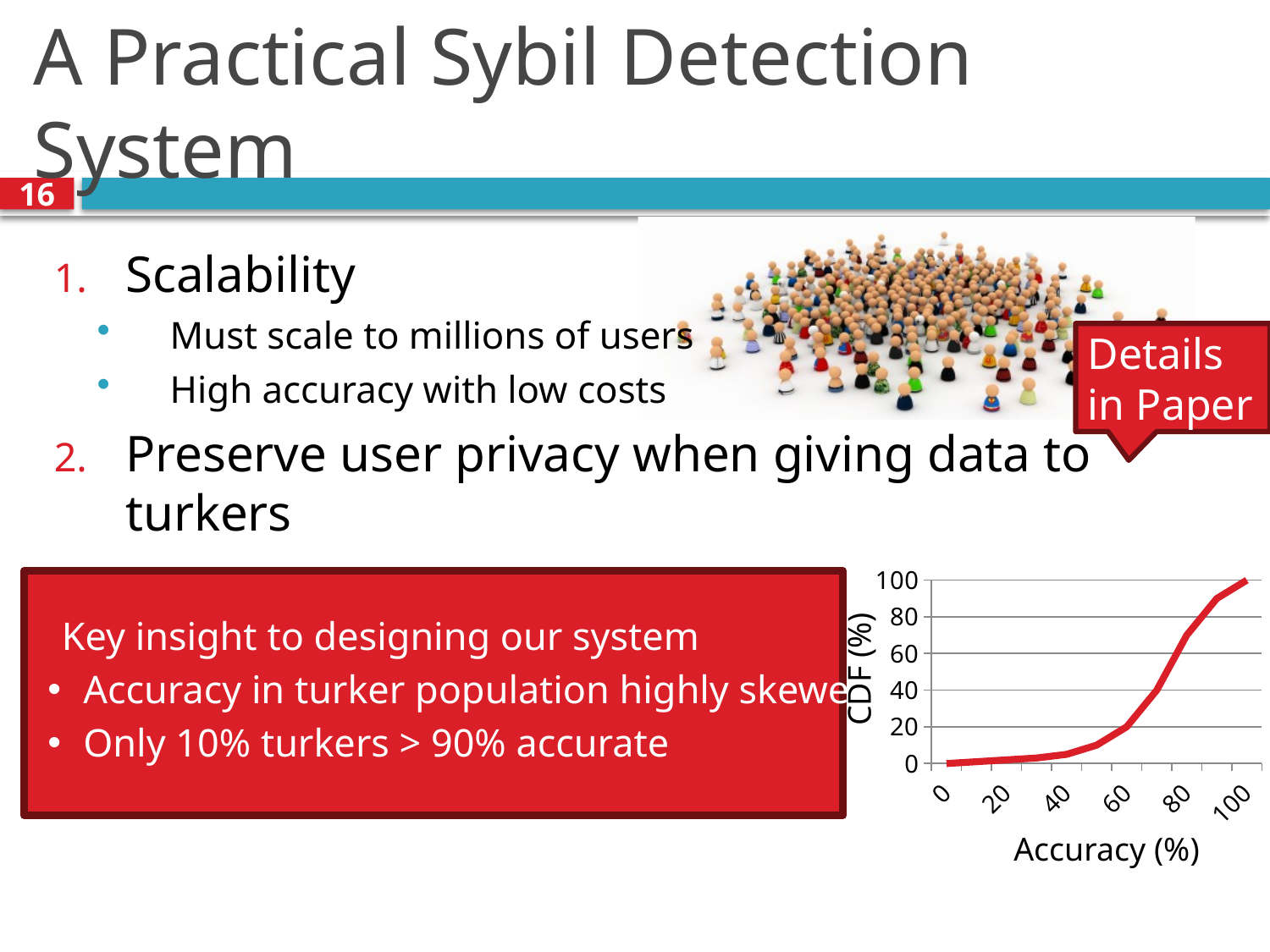
Is the CDF value at an accuracy of 100% greater or less than 80? greater What is the label of the y axis of the chart? CDF (%) How many tick labels are shown on the x axis of the chart? 6 What is the label of the x axis of the chart? Accuracy (%) Which accuracy value has the higher CDF, 60% or 80%? 80% Is the CDF value at an accuracy of 40% greater or less than 20? less Does the CDF curve rise or fall as Accuracy (%) increases along the x axis? rise Is the CDF value at an accuracy of 80% greater or less than 40? greater What is the highest value shown on the y axis of the chart? 100 What kind of chart is shown on the slide? line chart